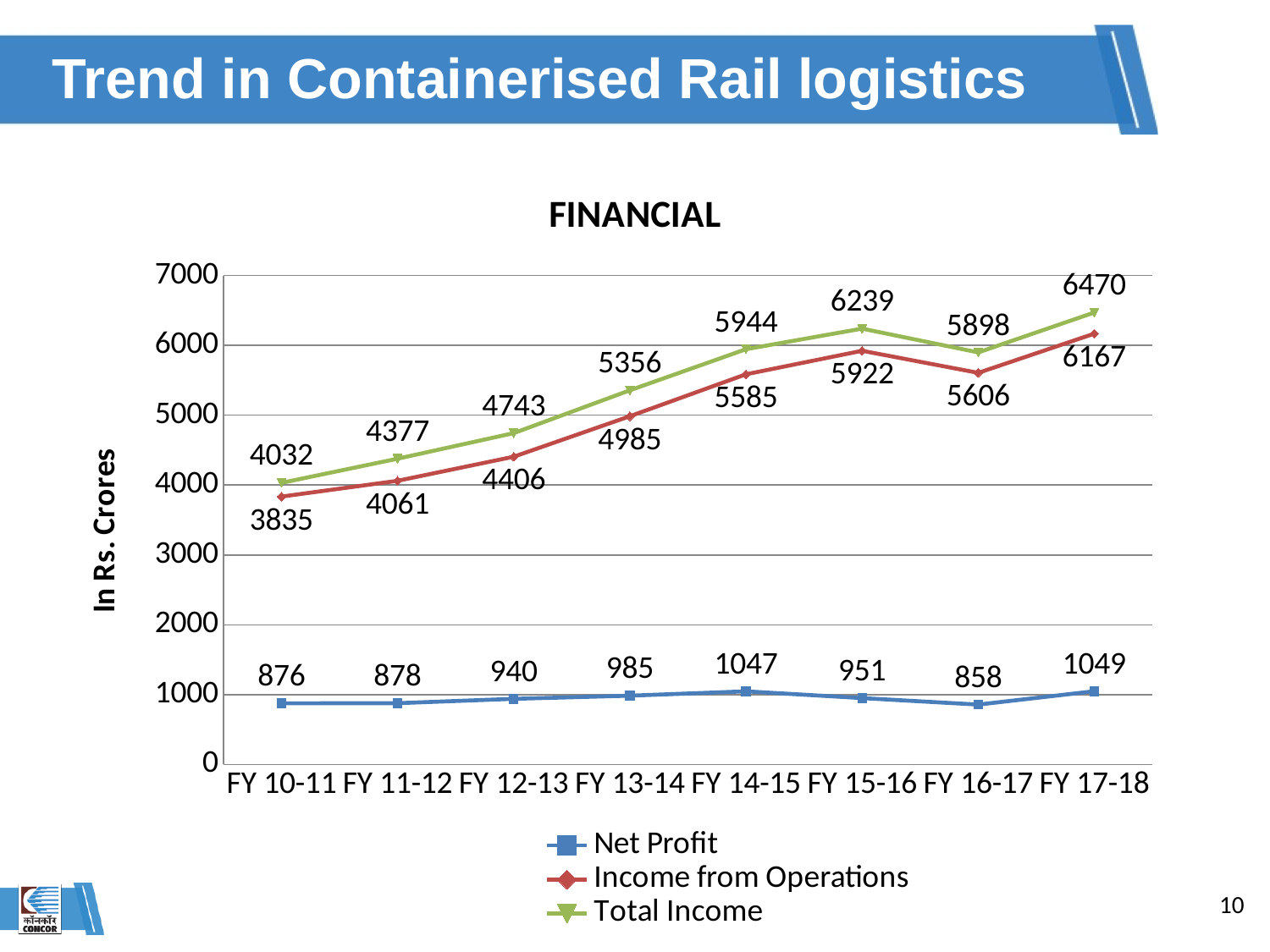
What kind of chart is shown? Line chart How many series does the legend list? 3 What is the difference between Total Income and Income from Operations in FY 15-16? 317 What is the y-axis label of the chart? In Rs. Crores In which fiscal year is Total Income lowest? FY 10-11 What is the Income from Operations for FY 13-14? 4985 In which fiscal year is Net Profit highest? FY 17-18 Does Income from Operations rise or fall from FY 15-16 to FY 16-17? Fall What is the Net Profit for FY 16-17? 858 How many fiscal years are shown on the x axis? 8 What is the Total Income for FY 17-18? 6470 Which is larger: Net Profit in FY 14-15 or Net Profit in FY 15-16? FY 14-15